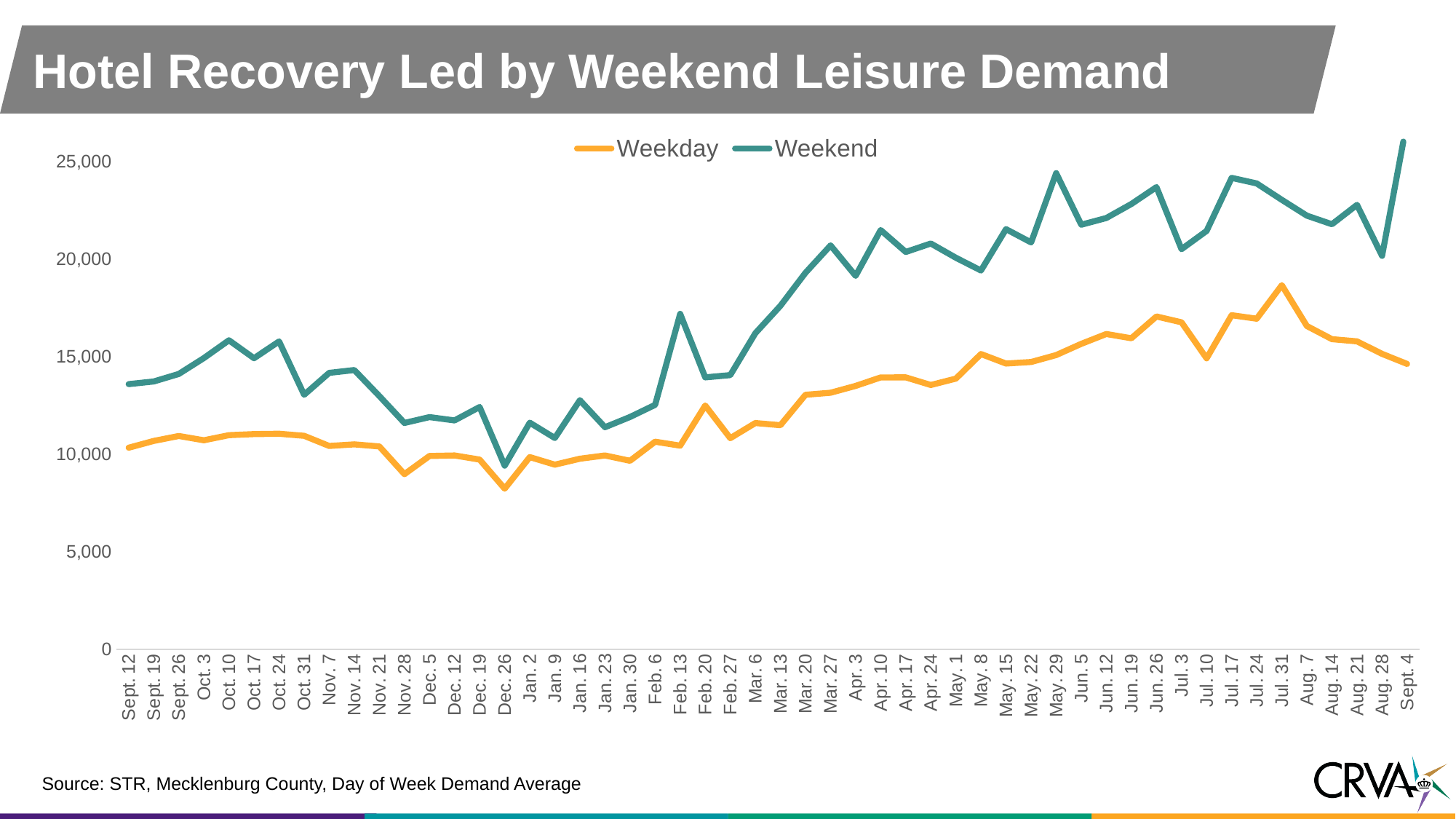
On which date does the Weekday series reach its lowest value? Dec. 26 What kind of chart is shown on the slide? Line chart Which series is higher on May 29, Weekday or Weekend? Weekend Which two series are shown in the legend? Weekday and Weekend How many series does the legend list? 2 Is the Weekday value for Dec. 26 greater or less than 10,000? less What is the title of the chart? Hotel Recovery Led by Weekend Leisure Demand How many weekly dates are plotted along the x axis? 52 On which date does the Weekend series reach its highest value? Sept. 4 On which date does the Weekend series reach its lowest value? Dec. 26 On which date does the Weekday series reach its highest value? Jul. 31 Is the Weekend value for Sept. 4 greater or less than 25,000? greater